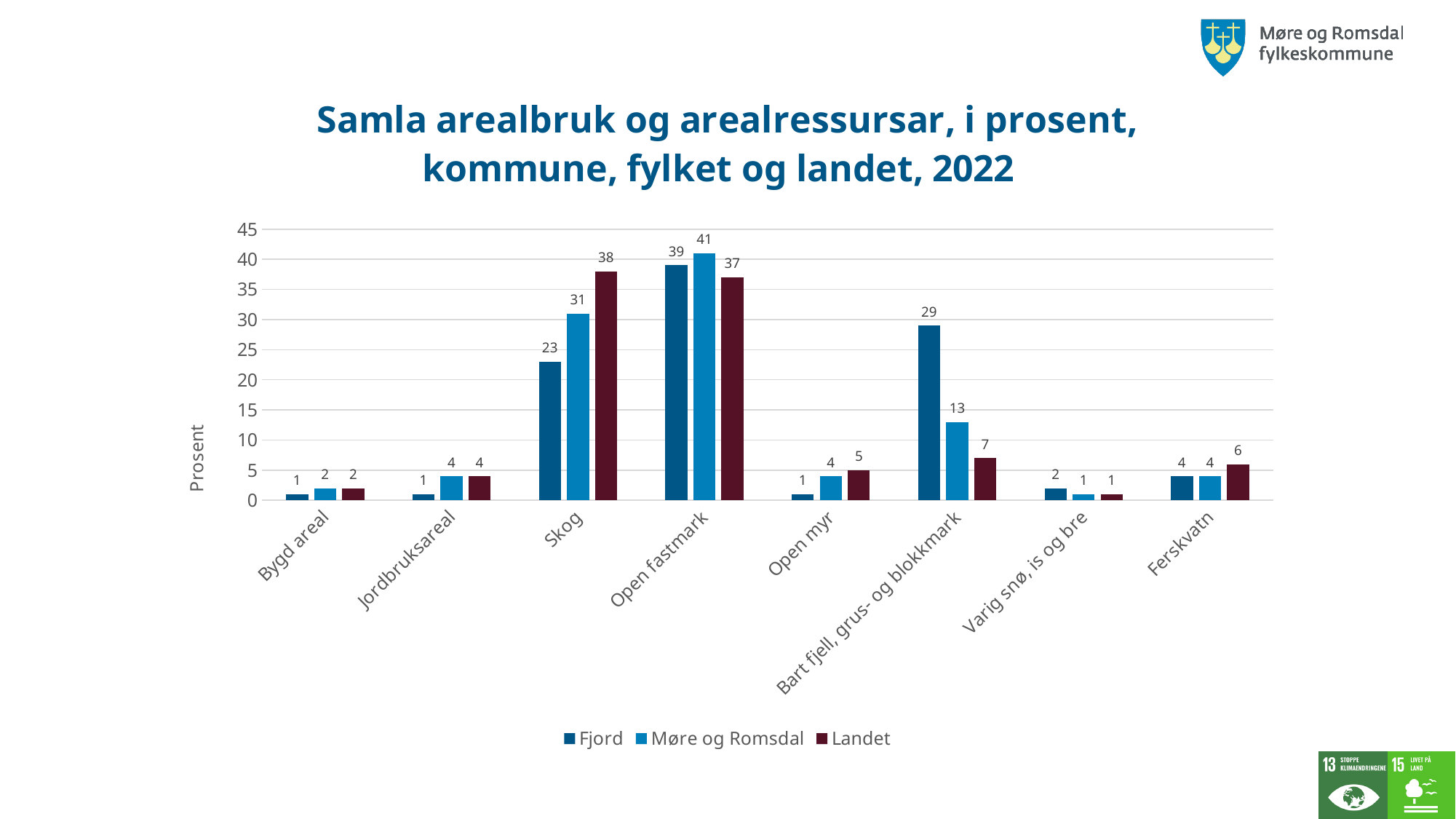
Is the value for Møre og Romsdal in the Skog category greater or less than 25? greater How many categories are shown on the x axis? 8 Which category has the highest value for the Landet series? Skog How many series does the legend list? 3 What is the value for Landet in the Bart fjell, grus- og blokkmark category? 7 What is the difference between the Fjord and Møre og Romsdal values in the Bart fjell, grus- og blokkmark category? 16 What kind of chart is shown on the slide? Bar chart Which is larger in the Open fastmark category: the Fjord value or the Landet value? Fjord Which category has the highest value for the Fjord series? Open fastmark What is the value for Møre og Romsdal in the Open fastmark category? 41 What is the difference between the Landet and Fjord values in the Skog category? 15 What is the value for Fjord in the Skog category? 23